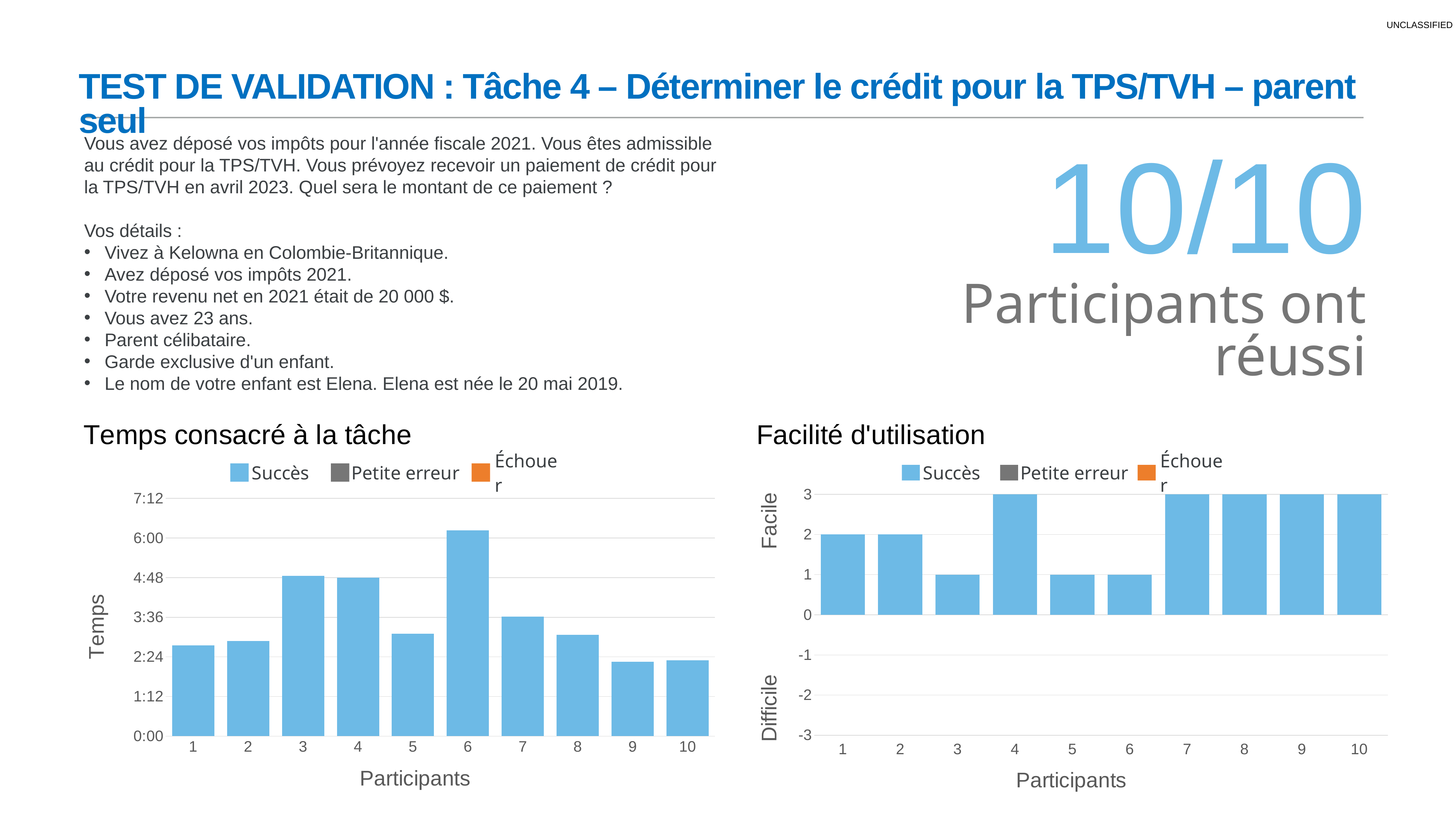
What is the label on the x axis of the "Facilité d'utilisation" chart? Participants In the "Temps consacré à la tâche" chart, which is larger, the value for participant 3 or participant 8? participant 3 How many participants are shown on the x axis of the "Temps consacré à la tâche" chart? 10 In the "Temps consacré à la tâche" chart, which participant has the highest value? 6 How many series does the legend of the "Facilité d'utilisation" chart list? 3 In the "Facilité d'utilisation" chart, what is the value for participant 4? 3 In the "Temps consacré à la tâche" chart, is the value for participant 9 greater or less than 2:24? less In the "Temps consacré à la tâche" chart, is the value for participant 6 greater or less than 6:00? greater In the "Temps consacré à la tâche" chart, is the value for participant 1 greater or less than 3:36? less What kind of chart is "Temps consacré à la tâche"? bar chart In the "Facilité d'utilisation" chart, what is the difference between the values for participant 7 and participant 1? 1 In the "Facilité d'utilisation" chart, what is the value for participant 3? 1